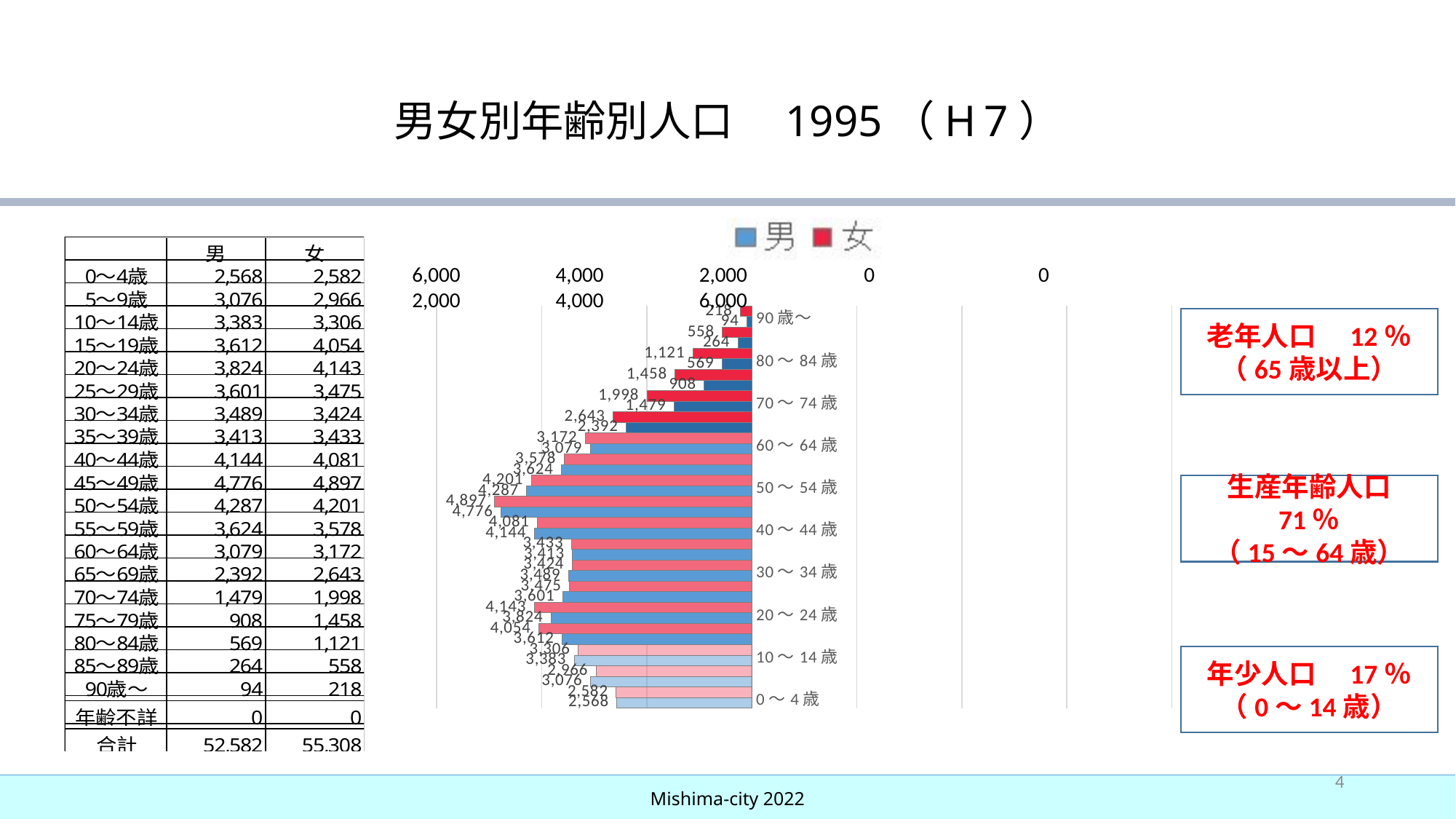
For the 20〜24歳 age group, which is larger, the 男 value or the 女 value? 女 What kind of chart is shown on the slide? Bar chart For the 15〜19歳 age group, how much larger is the 女 value than the 男 value? 442 Is the 男 value for the 50〜54歳 age group greater or less than 4,000? greater What is the 男 (male) value for the 0〜4歳 age group? 2,568 What is the 女 (female) value for the 70〜74歳 age group? 1,998 For the 40〜44歳 age group, what is the difference between the 男 value and the 女 value? 63 What is the 男 (male) value for the 45〜49歳 age group? 4,776 How many series does the legend list? 2 Which age group has the highest 男 (male) value? 45〜49歳 Which age group has the lowest 女 (female) value? 90歳〜 How many age groups are plotted in the chart? 19